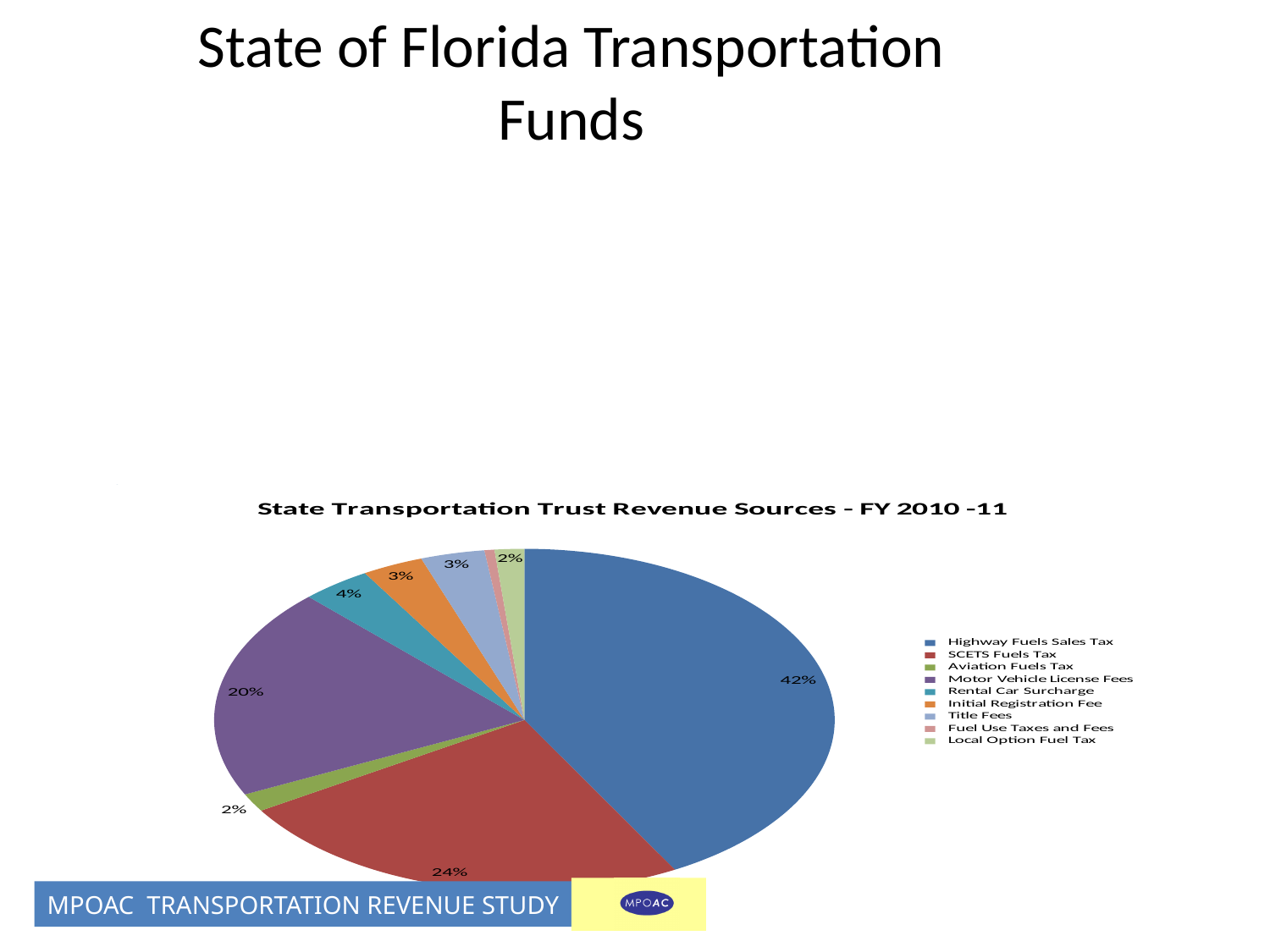
How many revenue sources does the legend list? 9 Which revenue source has the largest share of the pie? Highway Fuels Sales Tax What share of the pie does Aviation Fuels Tax represent? 2% What is the title of the chart? State Transportation Trust Revenue Sources - FY 2010 -11 Which is larger, the share for Motor Vehicle License Fees or the share for Rental Car Surcharge? Motor Vehicle License Fees What share of the pie does Motor Vehicle License Fees represent? 20% What colour is the slice for Highway Fuels Sales Tax? blue What share of the pie does Highway Fuels Sales Tax represent? 42% What is the difference in share between Highway Fuels Sales Tax and SCETS Fuels Tax? 18% What kind of chart is shown on the slide? pie chart